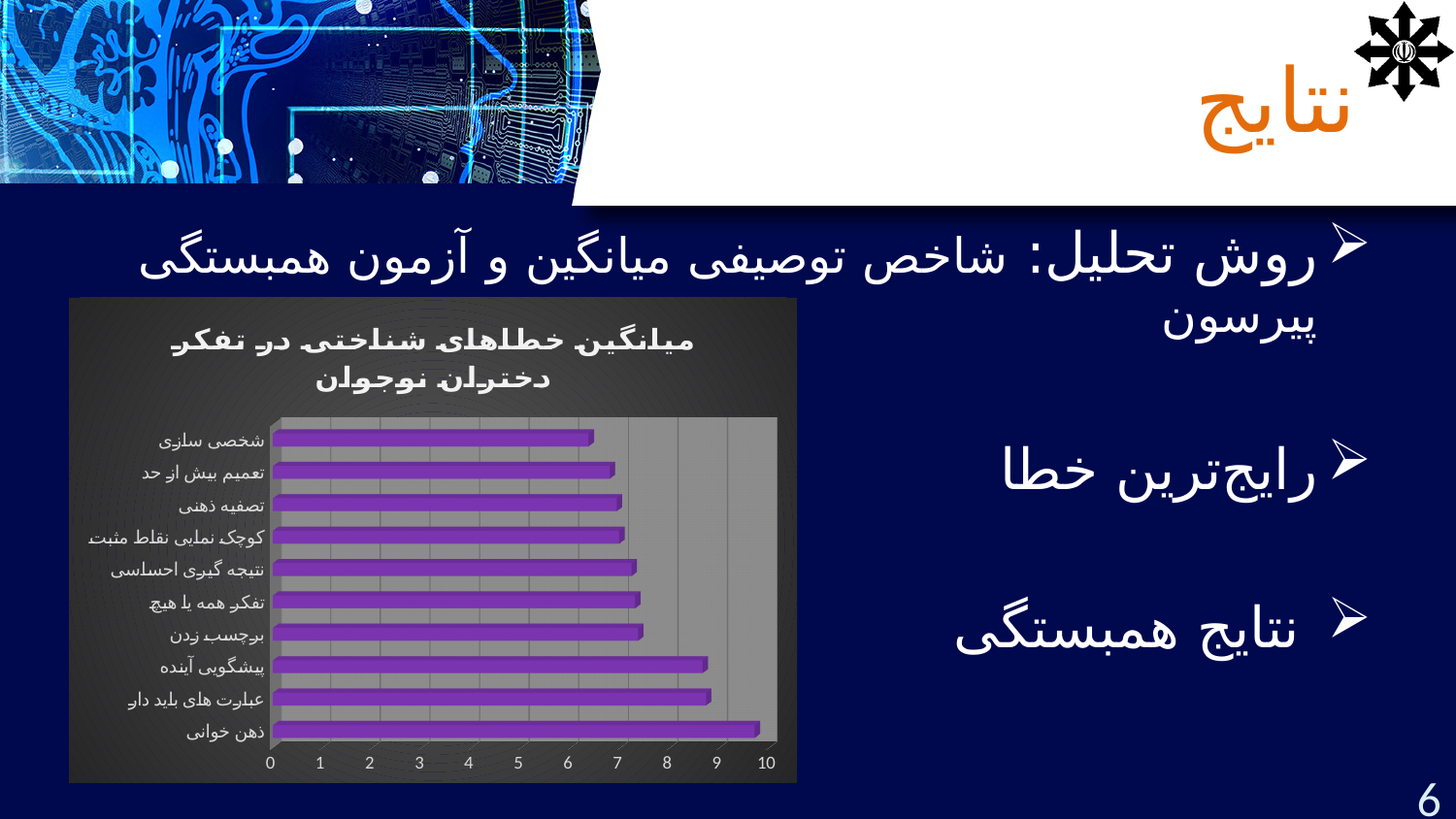
Which cognitive error has the highest mean value in the chart? ذهن خوانی What kind of chart is shown on the slide? bar chart Is the value for شخصی سازی greater or less than 7? less How many categories (cognitive errors) are plotted in the chart? 10 Is the value for پیشگویی آینده greater or less than 8? greater Is the value for ذهن خوانی greater or less than 9? greater What is the title of the chart? میانگین خطاهای شناختی در تفکر دختران نوجوان What colour are the bars in the chart? purple Which cognitive error has the lowest mean value in the chart? شخصی سازی Which has a larger value, ذهن خوانی or شخصی سازی? ذهن خوانی Which has a larger value, پیشگویی آینده or برچسب زدن? پیشگویی آینده